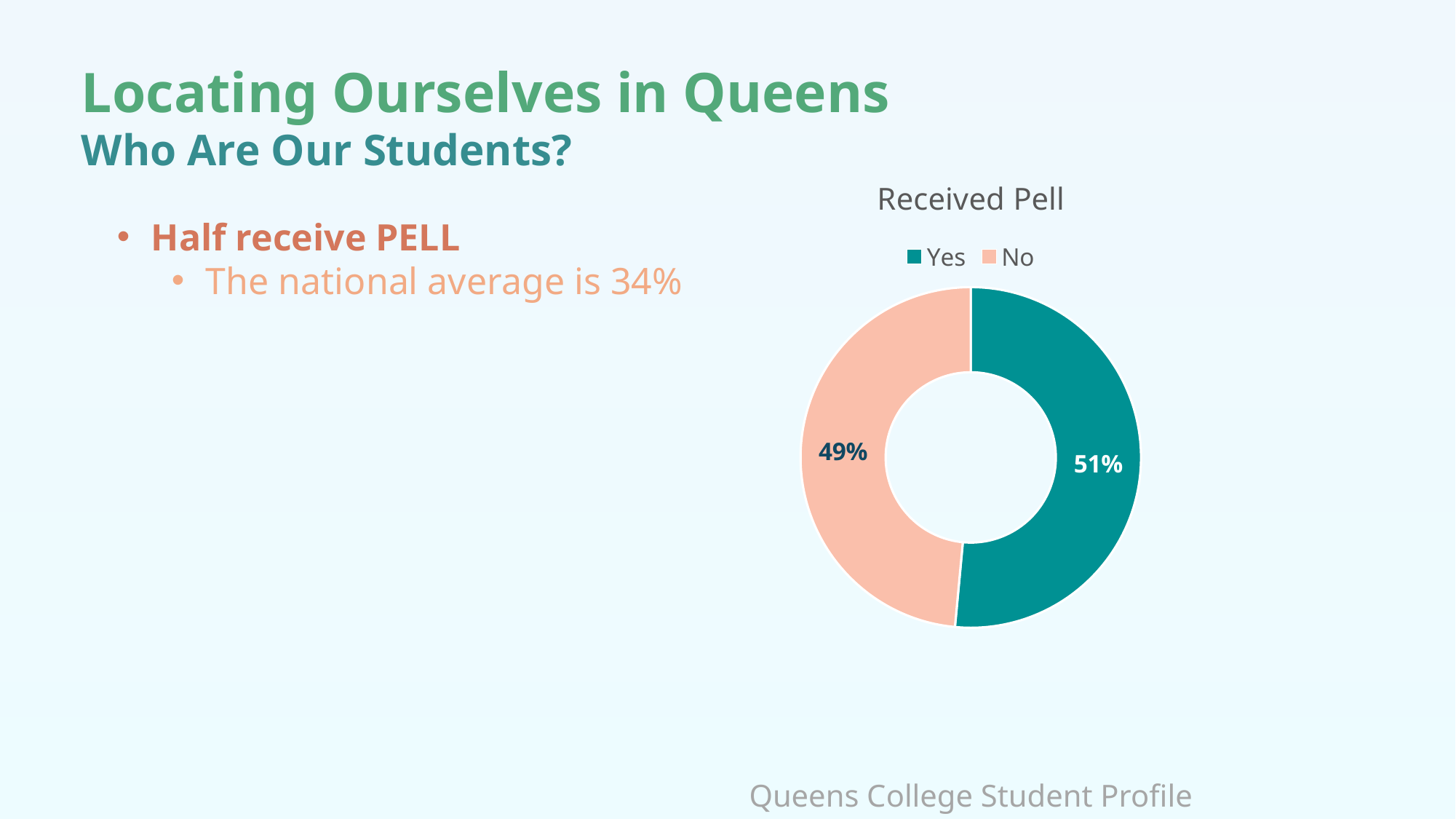
What kind of chart is shown on the slide? Pie chart (doughnut) How many slices does the chart have? 2 What percentage of students did not receive Pell (No)? 49% What share of the chart does the No slice represent? 49% How many categories does the legend list? 2 Which category has the largest share of the chart? Yes What colour is the Yes slice? Teal What is the title of the chart? Received Pell What is the difference in percentage points between the Yes and No slices? 2 Which slice is larger, Yes or No? Yes What percentage of students received Pell (Yes)? 51% Which category has the smallest share of the chart? No